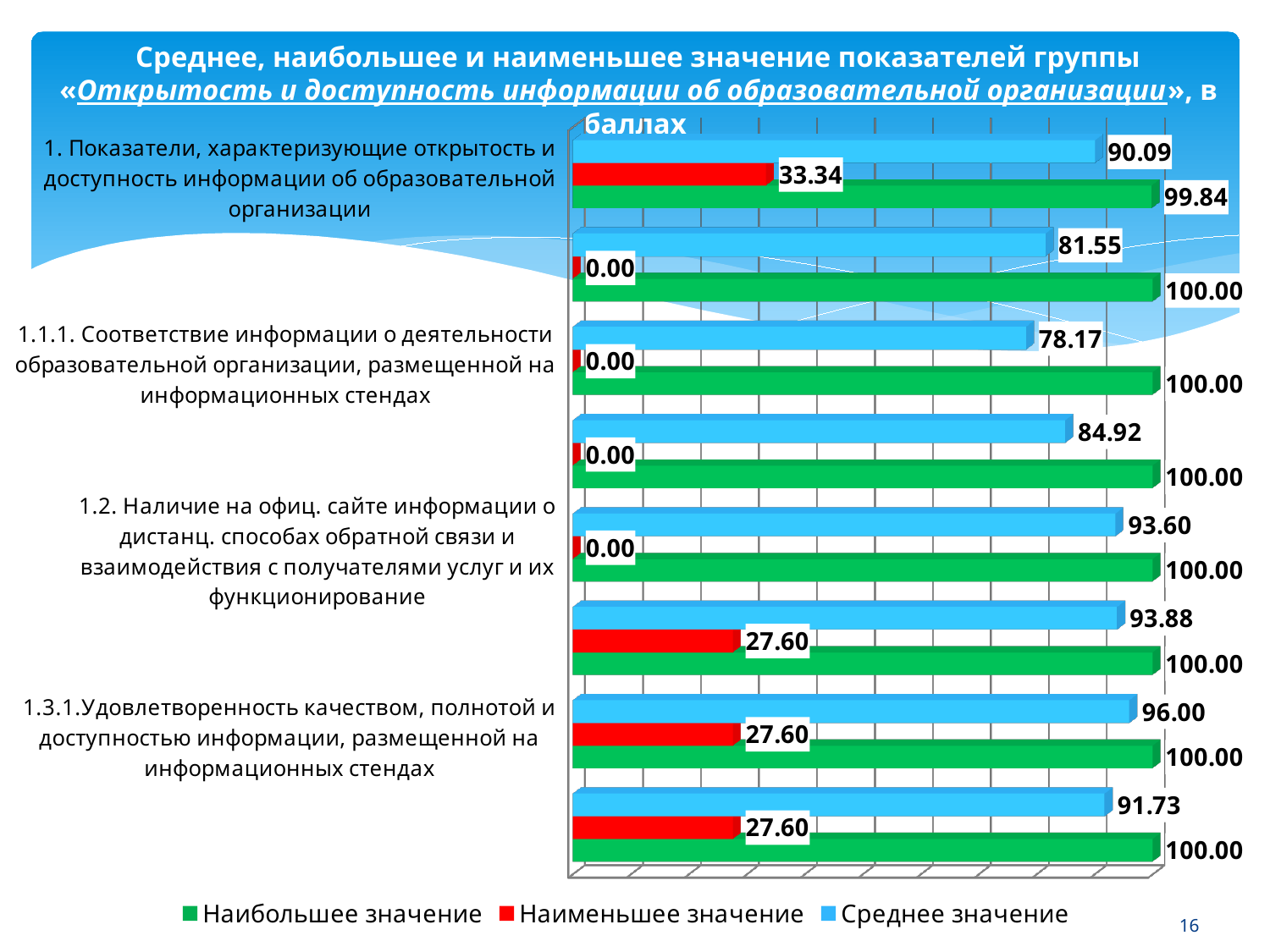
What is the average value (Среднее значение) for the category '1. Показатели, характеризующие открытость и доступность информации об образовательной организации'? 90.09 What kind of chart is shown on the slide? Bar chart What is the average value (Среднее значение) for the category '1.2. Наличие на офиц. сайте информации о дистанц. способах обратной связи и взаимодействия с получателями услуг и их функционирование'? 93.60 Which labeled category has the highest average value (Среднее значение)? 1.3.1.Удовлетворенность качеством, полнотой и доступностью информации, размещенной на информационных стендах Which labeled category has the lowest average value (Среднее значение)? 1.1.1. Соответствие информации о деятельности образовательной организации, размещенной на информационных стендах What is the maximum value (Наибольшее значение) for the category '1.1.1. Соответствие информации о деятельности образовательной организации, размещенной на информационных стендах'? 100.00 How many series does the legend list? 3 How many groups of bars are plotted on the chart? 8 Which is larger: the average value for '1.1.1. Соответствие информации...' or the average value for '1.3.1.Удовлетворенность качеством...'? 1.3.1.Удовлетворенность качеством... What is the minimum value (Наименьшее значение) for the category '1. Показатели, характеризующие открытость и доступность информации об образовательной организации'? 33.34 What is the minimum value (Наименьшее значение) for the category '1.3.1.Удовлетворенность качеством, полнотой и доступностью информации, размещенной на информационных стендах'? 27.60 What is the difference between the maximum and minimum values for the category '1. Показатели, характеризующие открытость и доступность информации об образовательной организации'? 66.50